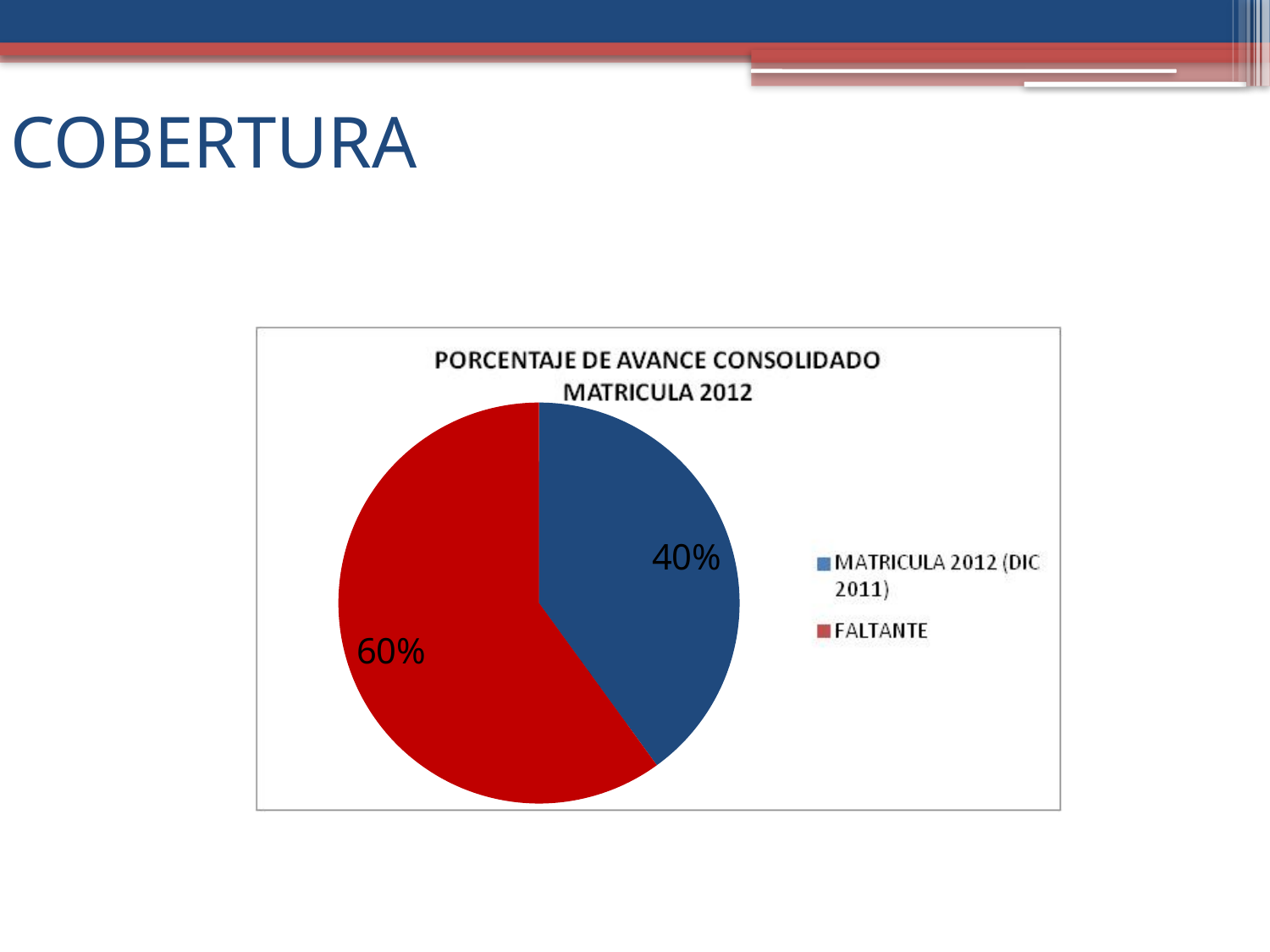
What share of the pie does FALTANTE represent? 60% Which is larger, the FALTANTE slice or the MATRICULA 2012 (DIC 2011) slice? FALTANTE How many slices does the pie chart have? 2 Which slice is the smallest? MATRICULA 2012 (DIC 2011) What is the title of the chart? PORCENTAJE DE AVANCE CONSOLIDADO MATRICULA 2012 How many entries does the legend list? 2 What kind of chart is shown on the slide? pie chart What colour is the FALTANTE slice? red Which slice is the largest? FALTANTE What is the difference in percentage points between FALTANTE and MATRICULA 2012 (DIC 2011)? 20% What share of the pie does MATRICULA 2012 (DIC 2011) represent? 40%